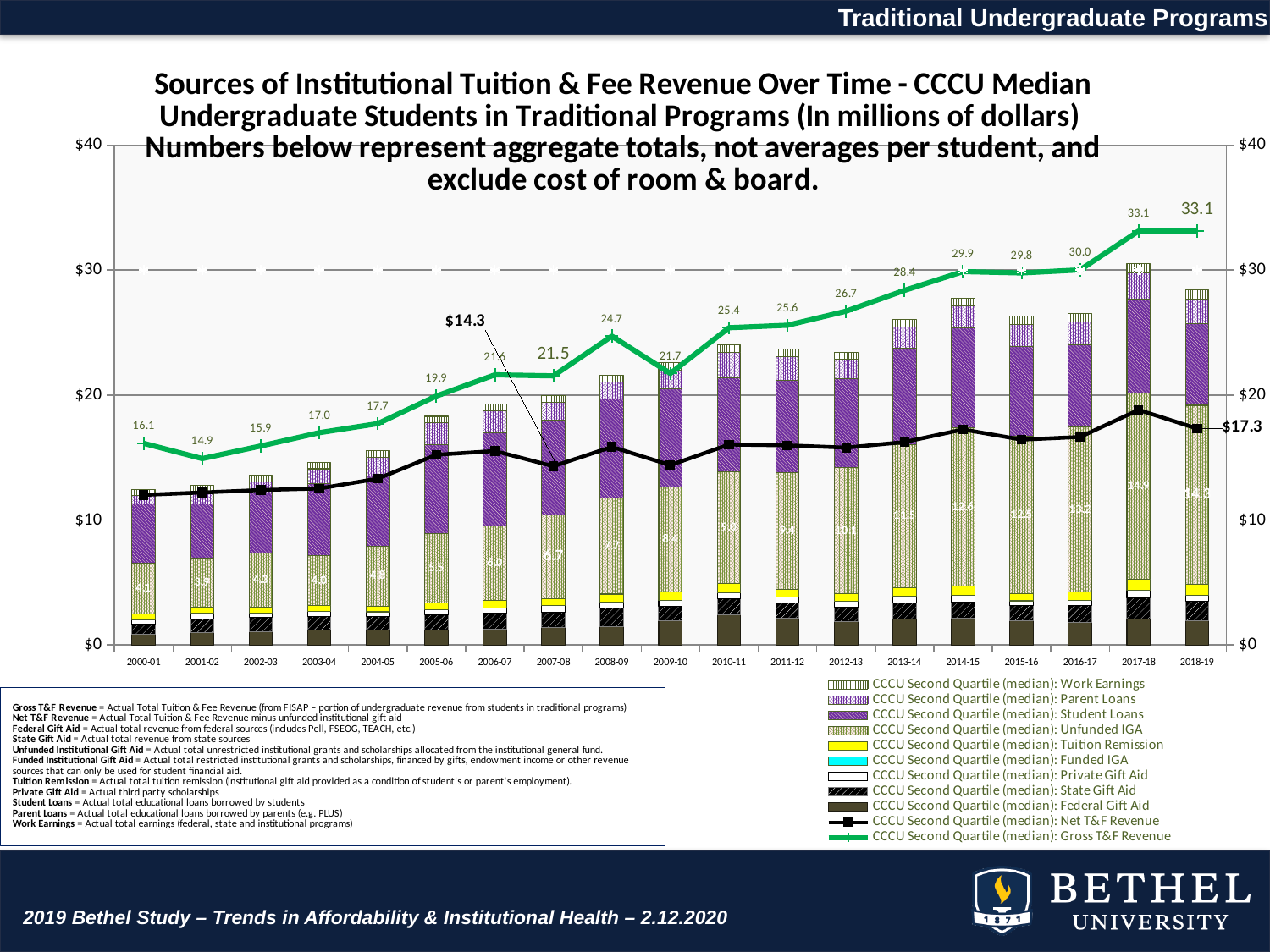
What is the CCCU median Net T&F Revenue for 2007-08? $14.3 By how much did Gross T&F Revenue increase from 2000-01 to 2018-19? 17.0 How many series does the legend list? 11 Is the Net T&F Revenue value for 2014-15 greater or less than $20? less What is the CCCU median Gross T&F Revenue for 2008-09? 24.7 What is the difference in Gross T&F Revenue between 2016-17 and 2017-18? 3.1 How many academic years are shown on the x axis? 19 Which year has the higher Gross T&F Revenue, 2008-09 or 2009-10? 2008-09 In which year is the Gross T&F Revenue line at its lowest value? 2001-02 What is the CCCU median Gross T&F Revenue for 2000-01? 16.1 Does the Gross T&F Revenue line generally rise or fall from 2000-01 to 2018-19? rise What is the CCCU median Net T&F Revenue for 2018-19? $17.3